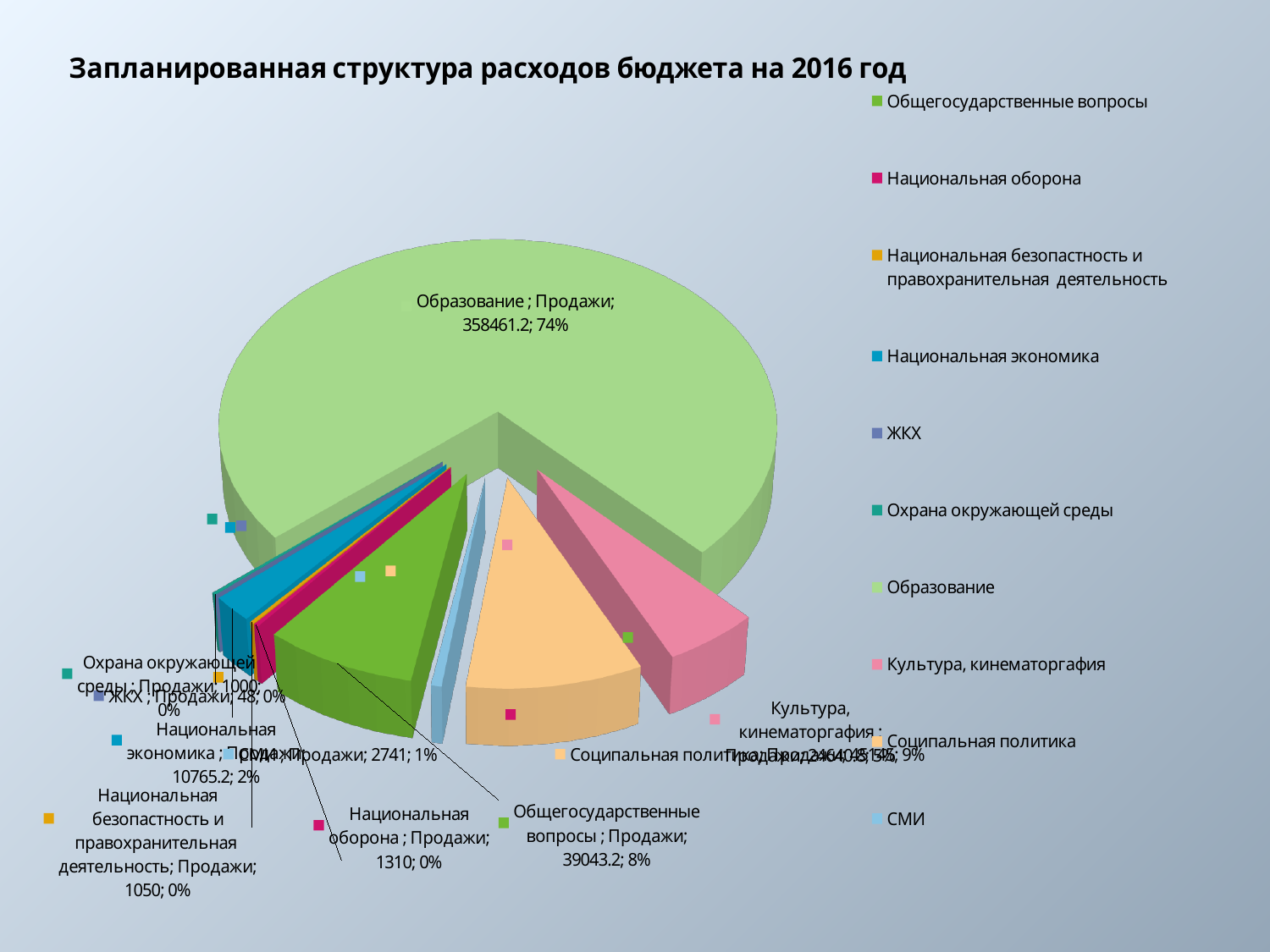
What is the value for Национальная экономика? 10765.2 What is the value for ЖКХ? 48 What is the value for Общегосударственные вопросы? 39043.2 How many categories does the legend list? 10 What kind of chart is shown on the slide? pie chart What share of the pie does Образование take? 74% Which is larger, the value for Национальная оборона or the value for Национальная безопастность и правохранительная деятельность? Национальная оборона Which category has the smallest value? ЖКХ What is the title of the chart? Запланированная структура расходов бюджета на 2016 год What share of the pie does Общегосударственные вопросы take? 8% Which category has the largest slice of the pie? Образование What is the value for Образование? 358461.2